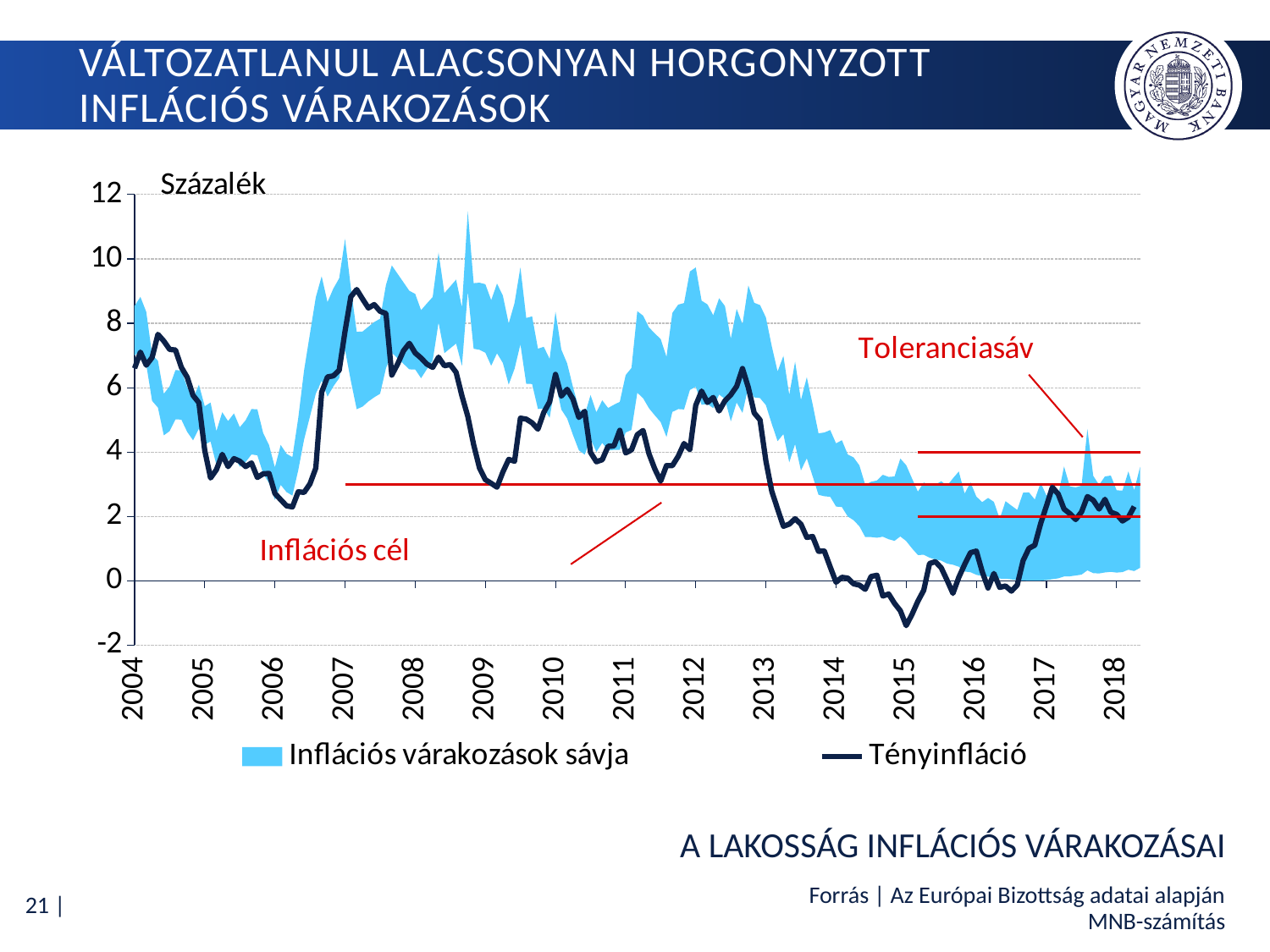
Does Tényinfláció rise or fall between 2012 and 2014? fall What unit is shown at the top of the y axis? Százalék How many series does the legend list? 2 Is the value of Tényinfláció at the start of 2004 greater or less than 6? greater What kind of chart is shown on the slide? line chart with a shaded band (area) Is the value of Tényinfláció at its 2007 peak greater or less than 8? greater In which year does Tényinfláció reach its lowest value? 2015 How many year labels are shown on the x axis? 15 Is the lowest value of Tényinfláció around 2015 greater or less than 0? less What are the two legend entries of the chart? Inflációs várakozások sávja; Tényinfláció Is the Tényinfláció value in 2007 larger or smaller than in 2016? larger In which year does Tényinfláció reach its highest value? 2007